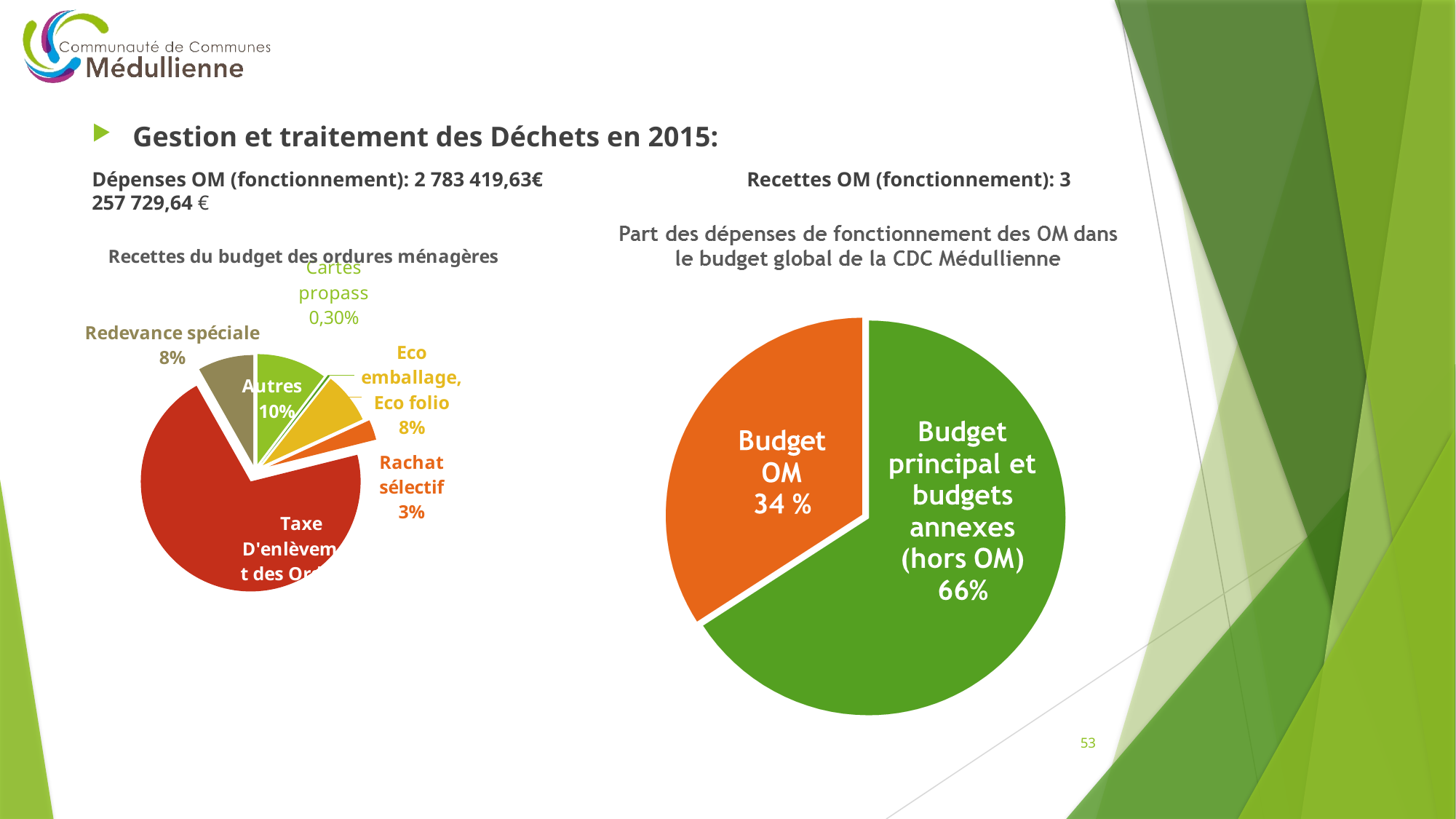
In the right-hand pie chart, how many percentage points larger is Budget principal et budgets annexes (hors OM) than Budget OM? 32 In the chart titled "Recettes du budget des ordures ménagères", which slice is the smallest? Cartes propass In the chart titled "Part des dépenses de fonctionnement des OM dans le budget global de la CDC Médullienne", what share is shown for Budget OM? 34 % In the chart titled "Recettes du budget des ordures ménagères", how many percentage points larger is Autres than Redevance spéciale? 2 How many slices does the right-hand pie chart have? 2 In the chart titled "Part des dépenses de fonctionnement des OM dans le budget global de la CDC Médullienne", what share is shown for Budget principal et budgets annexes (hors OM)? 66% In the right-hand pie chart, which slice is larger: Budget OM or Budget principal et budgets annexes (hors OM)? Budget principal et budgets annexes (hors OM) In the chart titled "Recettes du budget des ordures ménagères", what share is shown for Rachat sélectif? 3% In the chart titled "Recettes du budget des ordures ménagères", which slice is the largest? Taxe D'enlèvement des Ordures In the chart titled "Recettes du budget des ordures ménagères", what share is shown for Cartes propass? 0,30% In the chart titled "Recettes du budget des ordures ménagères", what share is shown for Autres? 10% What kind of chart is "Recettes du budget des ordures ménagères"? Pie chart